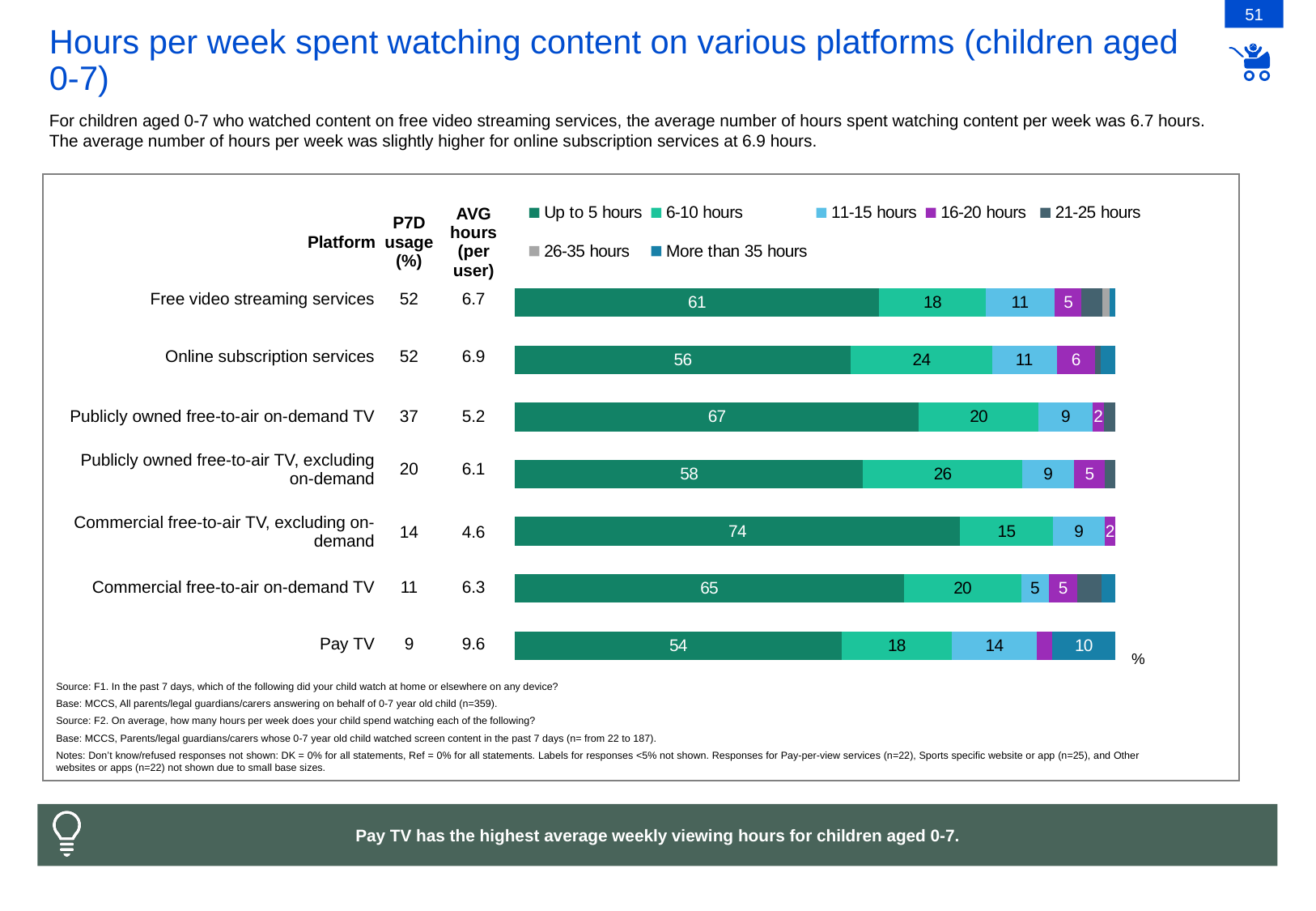
What is the difference between the '6-10 hours' values for Online subscription services and Free video streaming services? 6 Which platform has the lowest 'Up to 5 hours' share? Pay TV What kind of chart is shown on the slide? Stacked bar chart How many platforms are shown in the chart? 7 Which platform has the highest 'Up to 5 hours' share? Commercial free-to-air TV, excluding on-demand What is the '6-10 hours' value for Publicly owned free-to-air TV, excluding on-demand? 26 Which platform has the highest average hours per user? Pay TV Which has the larger '11-15 hours' value: Pay TV or Free video streaming services? Pay TV How many series does the legend list? 7 What is the P7D usage (%) for Publicly owned free-to-air on-demand TV? 37 What is the 'More than 35 hours' value for Pay TV? 10 What percentage of children aged 0-7 watching Commercial free-to-air TV, excluding on-demand, watch for up to 5 hours per week? 74